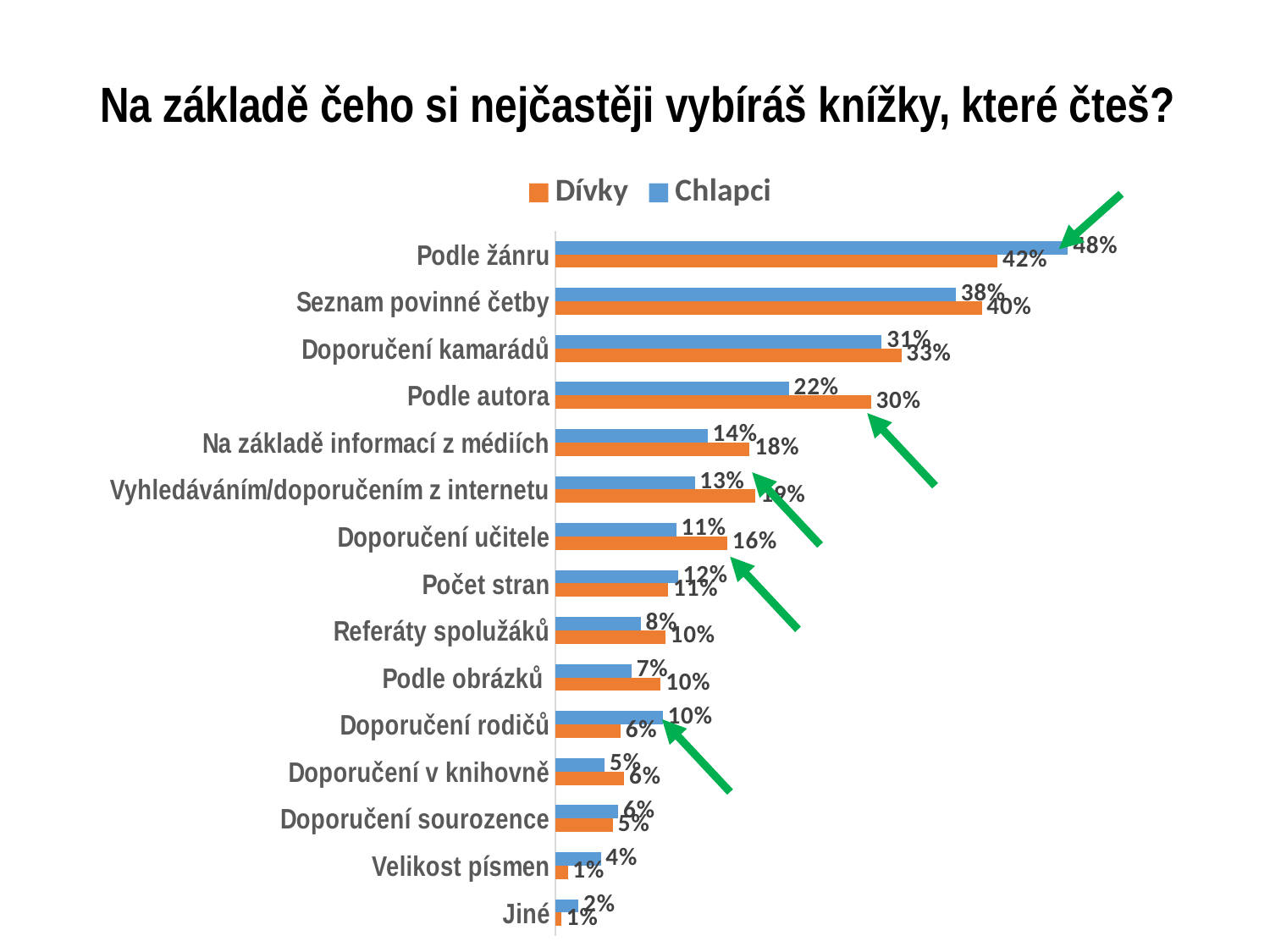
Which series is shown in orange in the legend? Dívky What is the value for Dívky in the category Doporučení učitele? 16% How many series does the legend list? 2 What kind of chart is shown on the slide? bar chart What is the value for Dívky in the category Podle autora? 30% Which category has the lowest value for Chlapci? Jiné How many categories are shown in the chart? 15 What is the value for Chlapci in the category Doporučení rodičů? 10% Which category has the highest value for Dívky? Podle žánru For Seznam povinné četby, which series has the larger value, Dívky or Chlapci? Dívky What is the difference between the Dívky and Chlapci values for Podle autora? 8% What is the value for Chlapci in the category Podle žánru? 48%